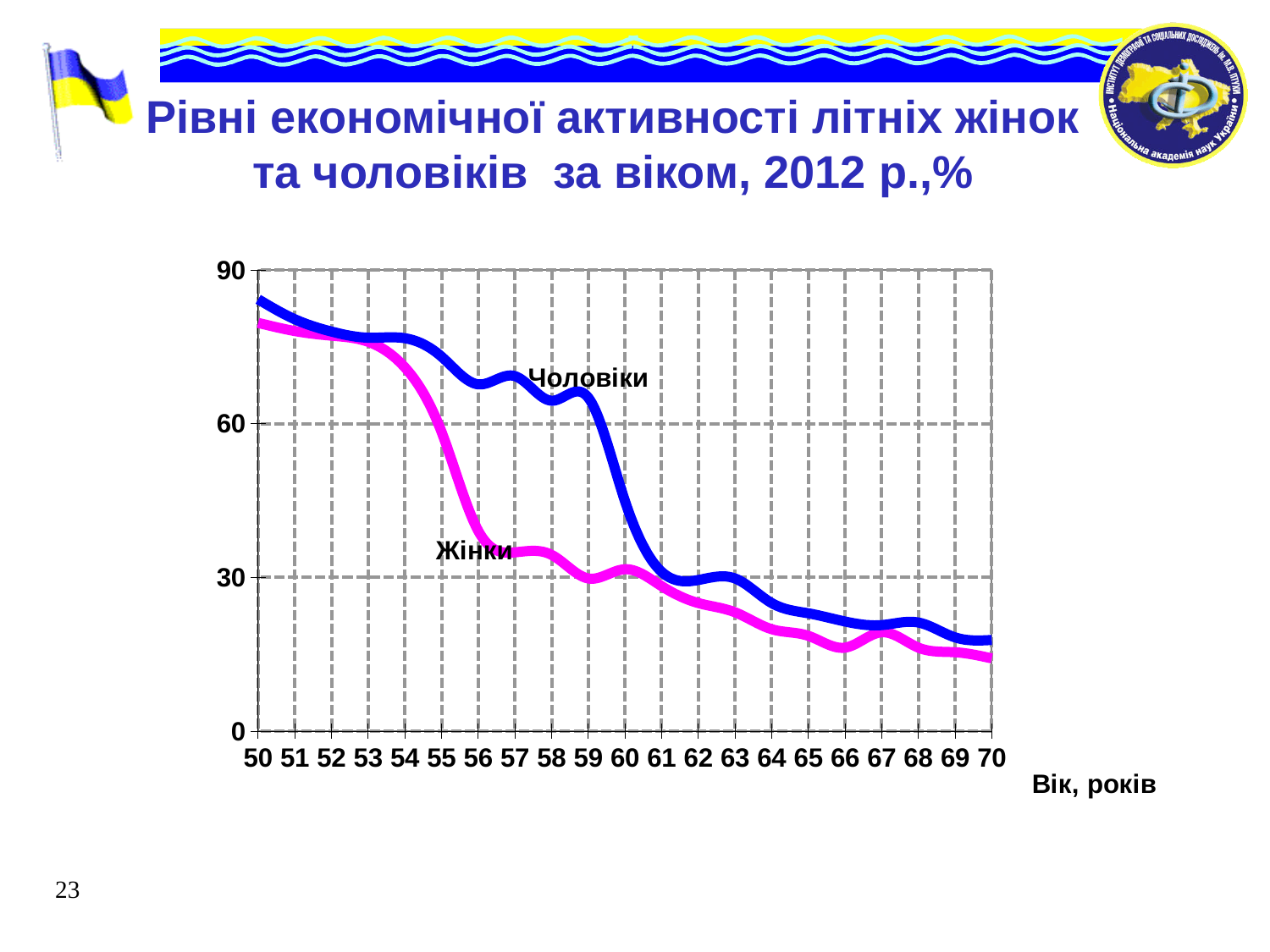
What kind of chart is shown on the slide? line chart What is the label of the x axis of the chart? Вік, років Is the value for Жінки at age 70 greater or less than 30? less Is the value for Чоловіки at age 58 greater or less than 60? greater Which series is drawn in blue on the chart? Чоловіки How many data series are plotted on the chart? 2 How many age points are marked along the x axis of the chart? 21 At age 60, which series has the higher value, Чоловіки or Жінки? Чоловіки Is the value for Чоловіки at age 60 greater or less than 60? less Do the values for Жінки rise or fall as age increases from 50 to 70? fall